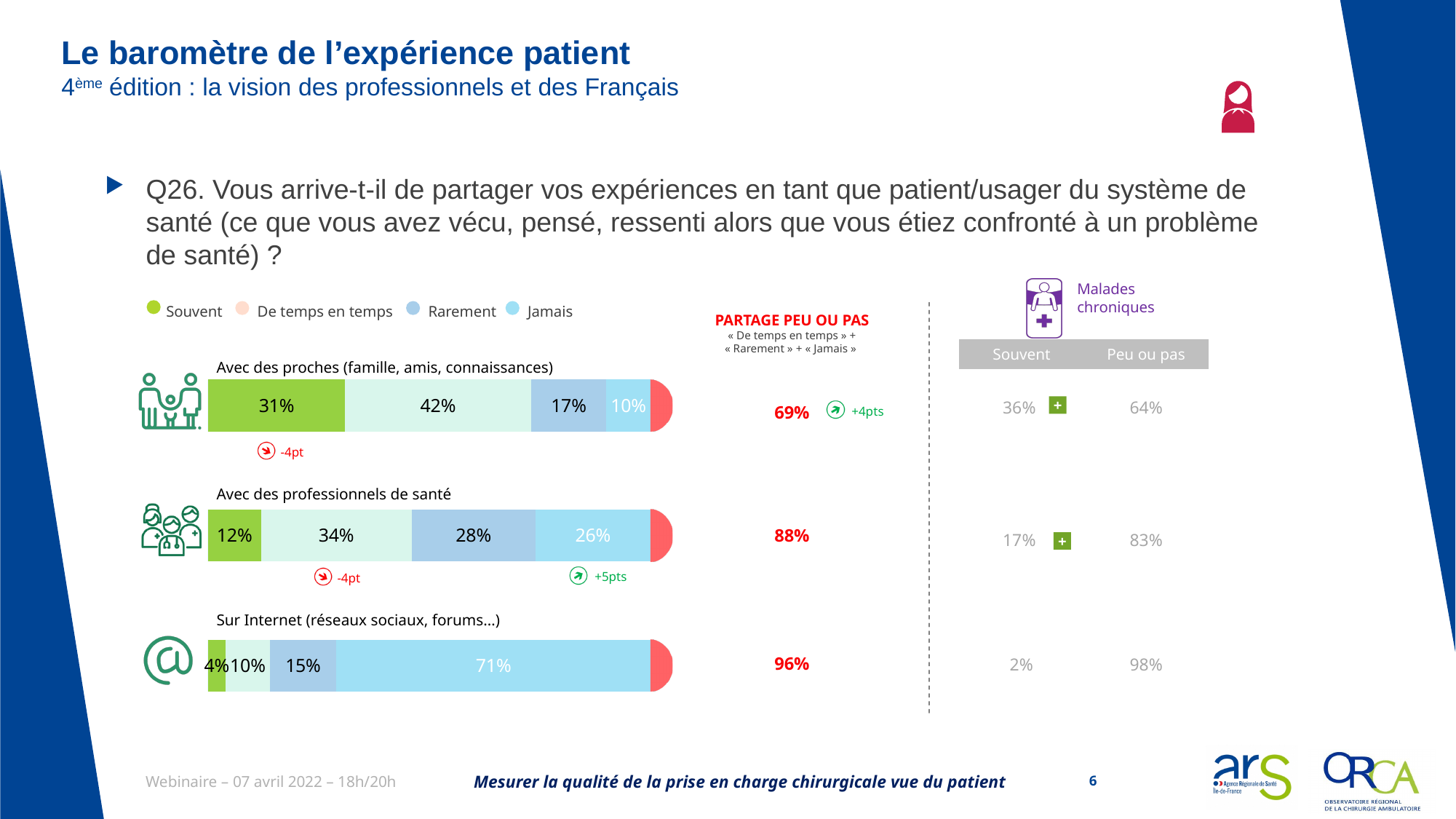
What kind of chart is used to show the Q26 results? Stacked bar chart What percentage answered "Rarement" for "Avec des professionnels de santé"? 28% What is the "PARTAGE PEU OU PAS" value for "Sur Internet (réseaux sociaux, forums…)"? 96% What percentage answered "Jamais" for "Sur Internet (réseaux sociaux, forums…)"? 71% In the "Malades chroniques" table, what is the "Souvent" value for "Avec des professionnels de santé"? 17% What percentage of respondents answered "Souvent" for "Avec des proches (famille, amis, connaissances)"? 31% Which is larger: the "Jamais" share for "Avec des professionnels de santé" or for "Avec des proches"? Avec des professionnels de santé Which category has the highest "Souvent" share? Avec des proches (famille, amis, connaissances) What is the difference between the "De temps en temps" share for "Avec des proches" and for "Avec des professionnels de santé"? 8 points How many categories (sharing channels) are shown in the chart? 3 Which category has the lowest "Souvent" share? Sur Internet (réseaux sociaux, forums…) How many series does the legend list? 4